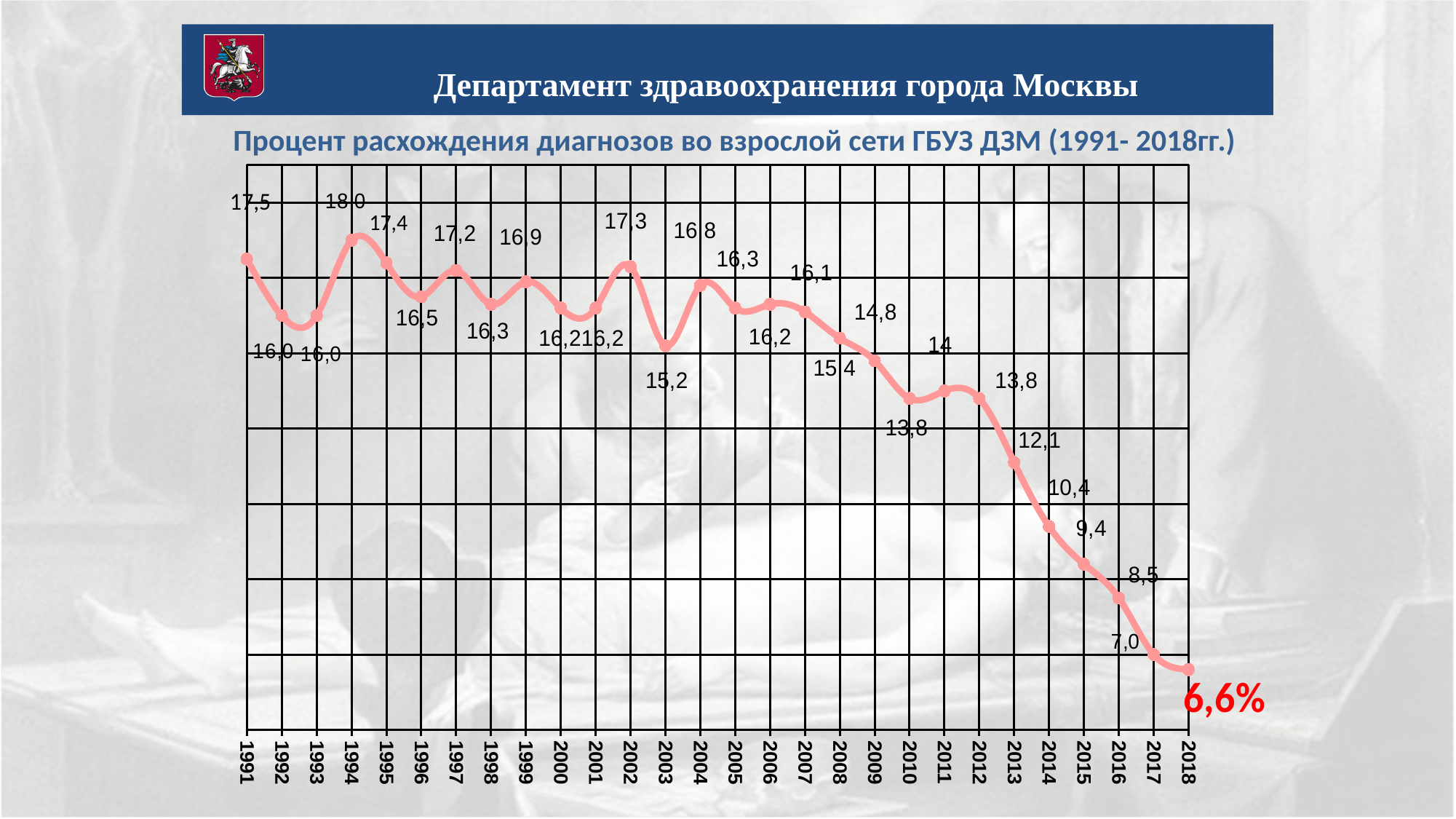
How many years are plotted on the x axis? 28 What is the value for 2013? 12,1 What is the value for 2003? 15,2 What type of chart is shown on the slide? line chart What is the value for 2018? 6,6% Which year has the lowest value? 2018 Do the values generally rise or fall from 2007 to 2018? fall Which year has the highest value? 1994 What is the value for 1994? 18,0 What is the value for 1991? 17,5 What is the difference between the values for 1991 and 2018? 10,9 Which year has the larger value, 2014 or 2016? 2014